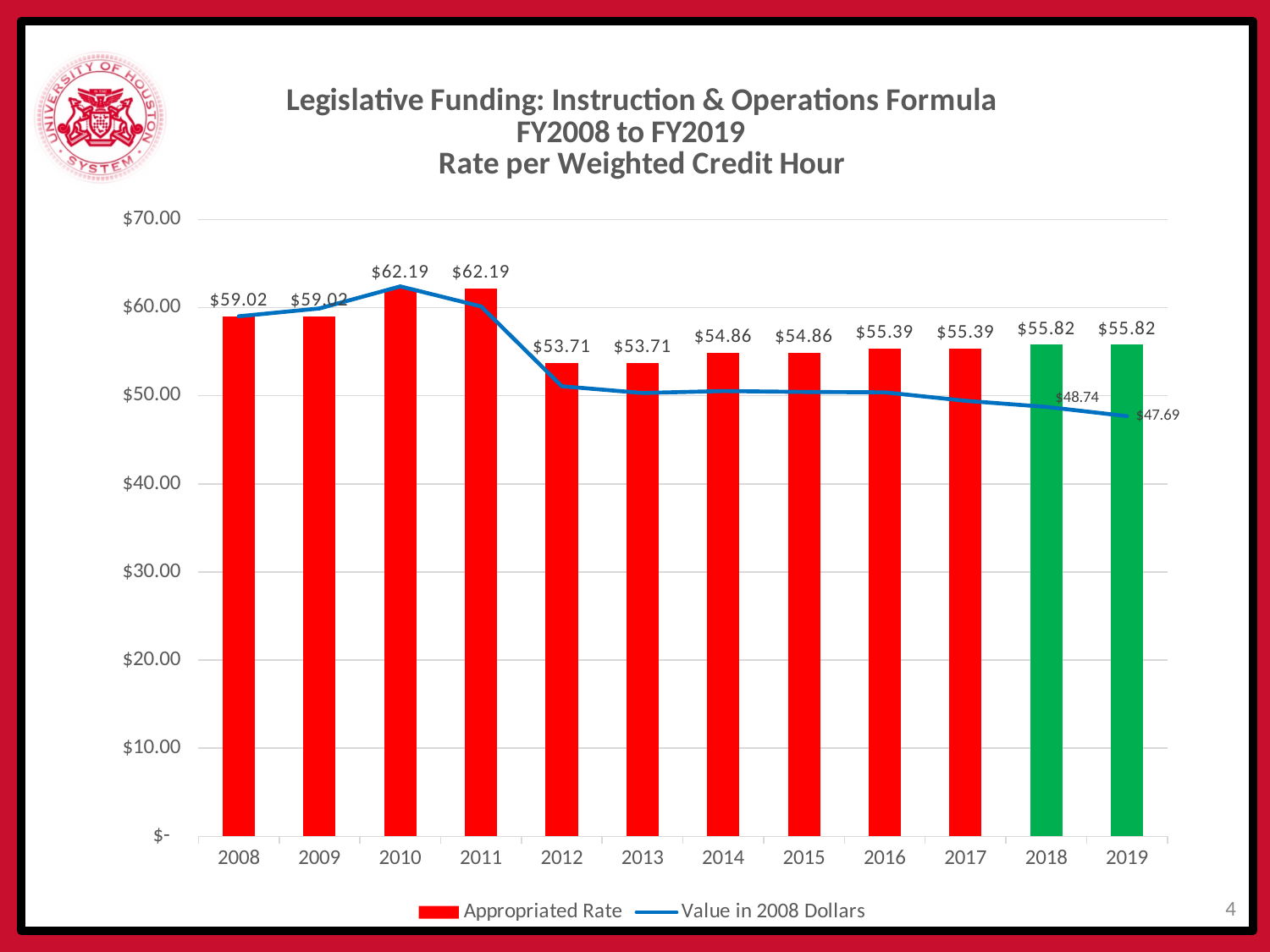
What is the Value in 2008 Dollars for 2019? $47.69 What is the difference between the Appropriated Rate in 2011 and in 2012? $8.48 Does the Value in 2008 Dollars line rise or fall from 2011 to 2019? fall Is the Value in 2008 Dollars for 2014 greater or less than $60.00? less Which is larger, the Appropriated Rate in 2008 or in 2019? 2008 How many series does the legend list? 2 What is the Appropriated Rate for 2013? $53.71 What colour are the bars for 2018 and 2019? green Which year has the lowest Appropriated Rate? 2012 and 2013 How many years are shown on the x axis? 12 What is the Value in 2008 Dollars for 2018? $48.74 What is the Appropriated Rate for 2010? $62.19